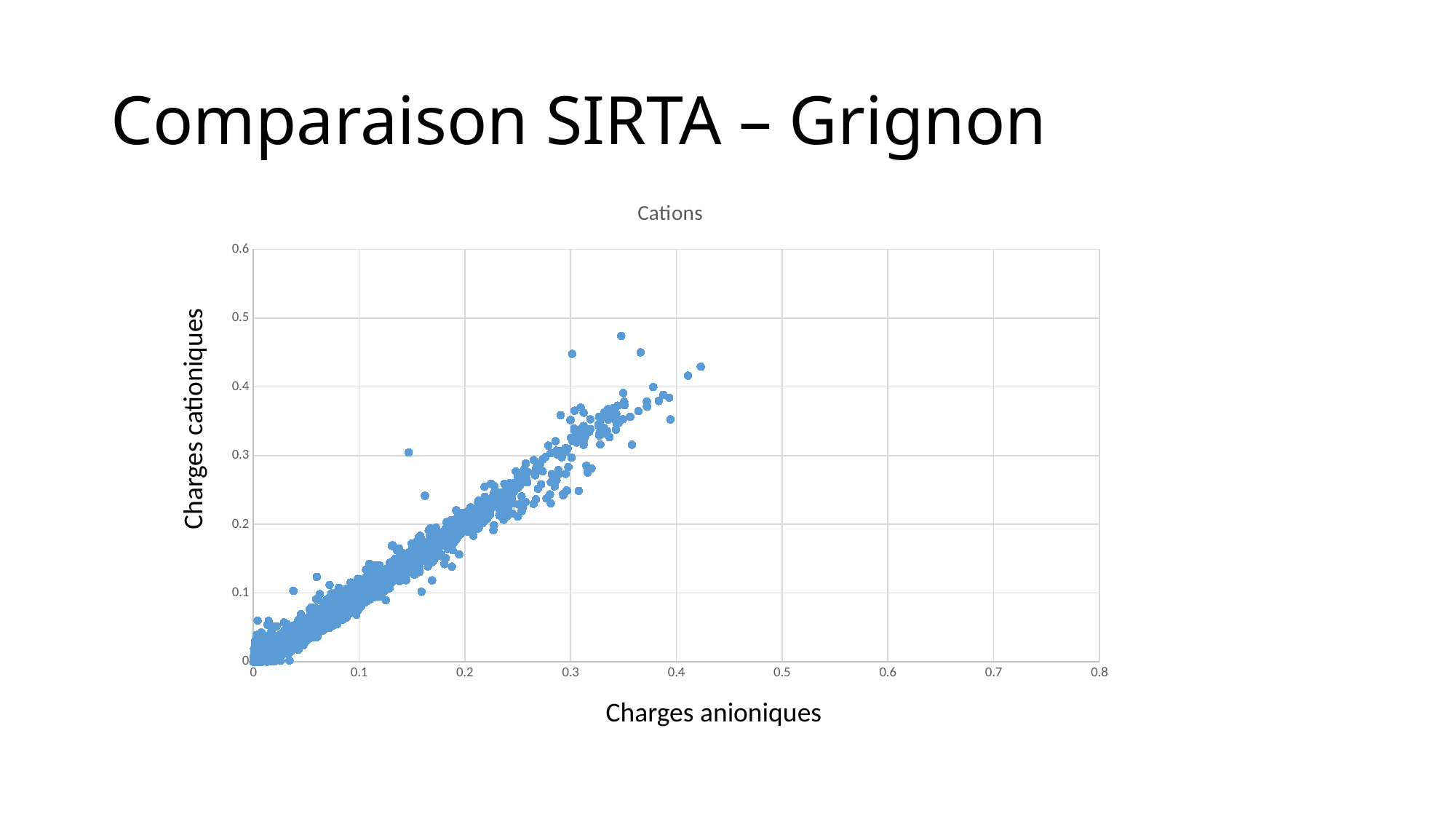
What is the label of the horizontal axis of the chart? Charges anioniques Do the cationic charge values rise or fall as the anionic charge increases along the x axis? Rise Is the largest plotted value of Charges anioniques greater or less than 0.3? greater Is the largest plotted value of Charges anioniques greater or less than 0.5? less What is the title of the chart? Cations What kind of chart is shown on the slide? Scatter chart Are there any points plotted with Charges anioniques greater than 0.6? No